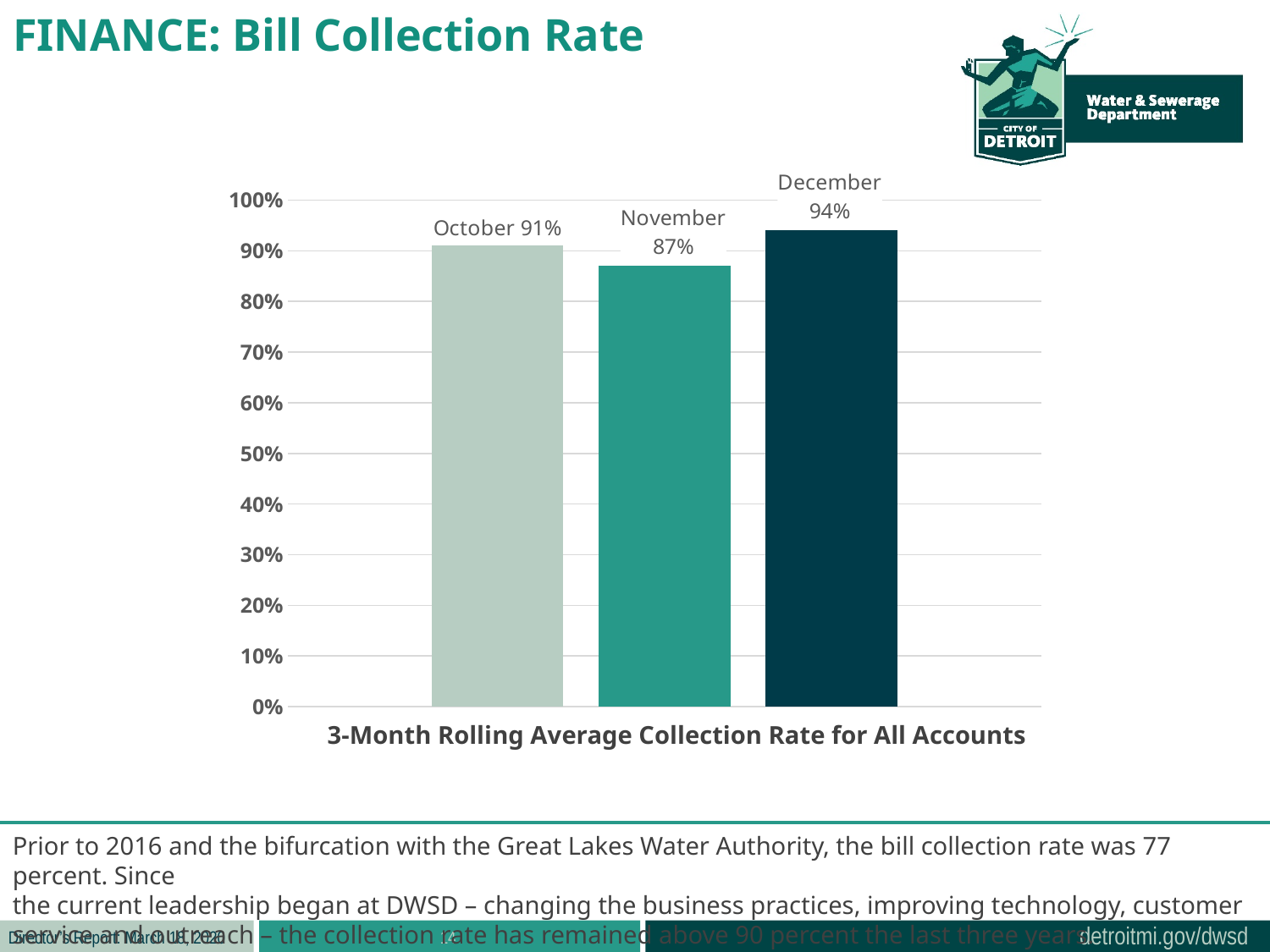
What is the title shown below the chart's x axis? 3-Month Rolling Average Collection Rate for All Accounts Which is larger, the collection rate for October or for December? December What is the difference between the October and November collection rates? 4% Is the value for November greater or less than 90%? less What kind of chart is shown on the slide? Bar chart What is the collection rate for November? 87% Which month has the lowest collection rate? November How many months are shown in the chart? 3 What is the collection rate for October? 91% Which month has the highest collection rate? December What is the difference between the December and November collection rates? 7% What is the collection rate for December? 94%